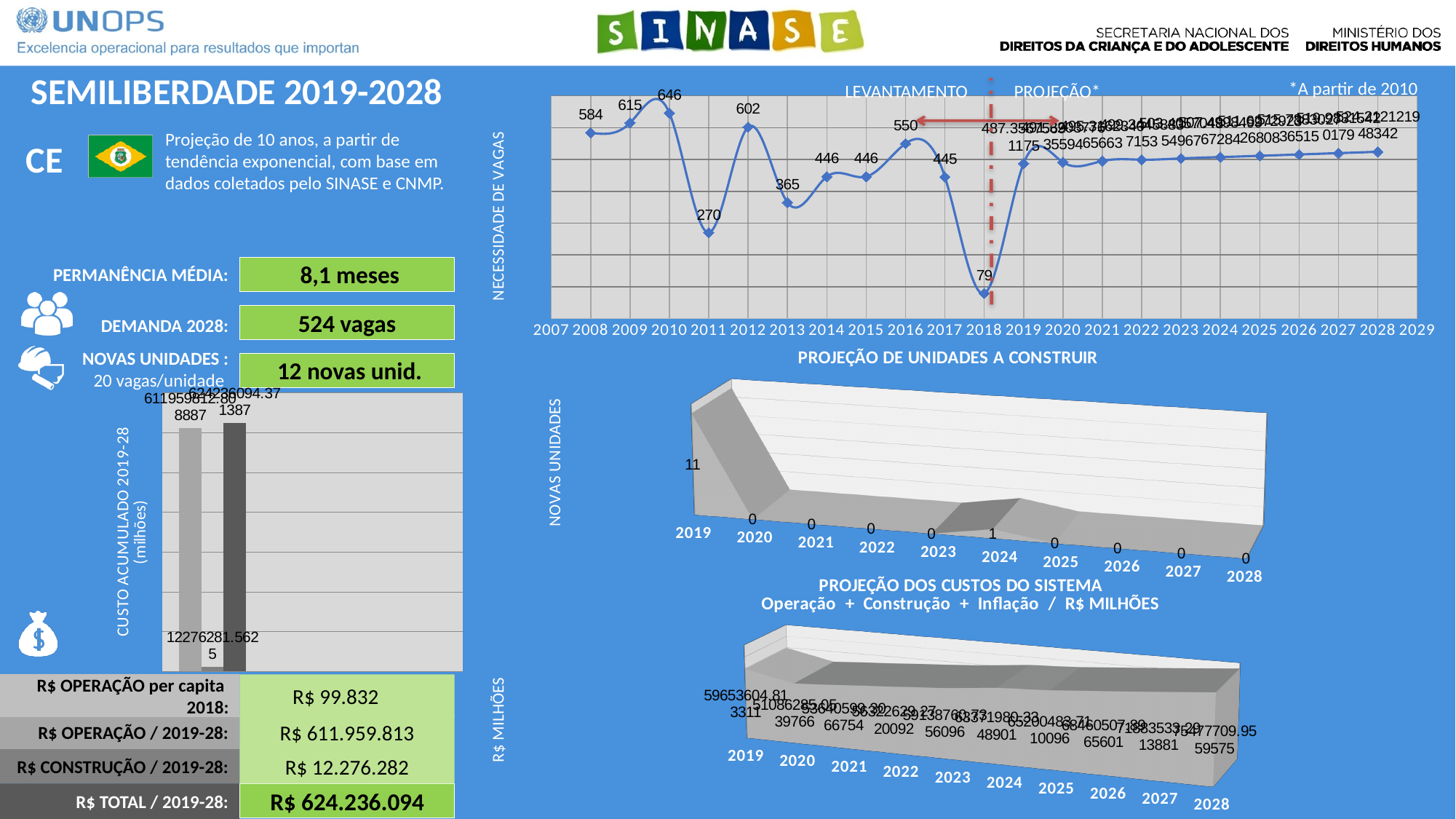
In the PROJEÇÃO DE UNIDADES A CONSTRUIR chart, what is the value for 2024? 1 In the NECESSIDADE DE VAGAS line chart, what is the value for 2018? 79 In the NECESSIDADE DE VAGAS line chart, which year has the larger value, 2012 or 2013? 2012 In the NECESSIDADE DE VAGAS line chart, what is the difference between the 2010 value and the 2011 value? 376 In the NECESSIDADE DE VAGAS line chart, what is the value for 2010? 646 What kind of chart is the NECESSIDADE DE VAGAS chart at the top right? line chart In the NECESSIDADE DE VAGAS line chart, what is the value for 2011? 270 In the NECESSIDADE DE VAGAS line chart, do the values rise or fall from 2013 to 2016? rise In the PROJEÇÃO DE UNIDADES A CONSTRUIR chart, what is the value for 2019? 11 In the NECESSIDADE DE VAGAS line chart, which year has the lowest value? 2018 In the NECESSIDADE DE VAGAS line chart, which year has the highest labelled value? 2010 How many years are shown on the x axis of the PROJEÇÃO DE UNIDADES A CONSTRUIR chart? 10